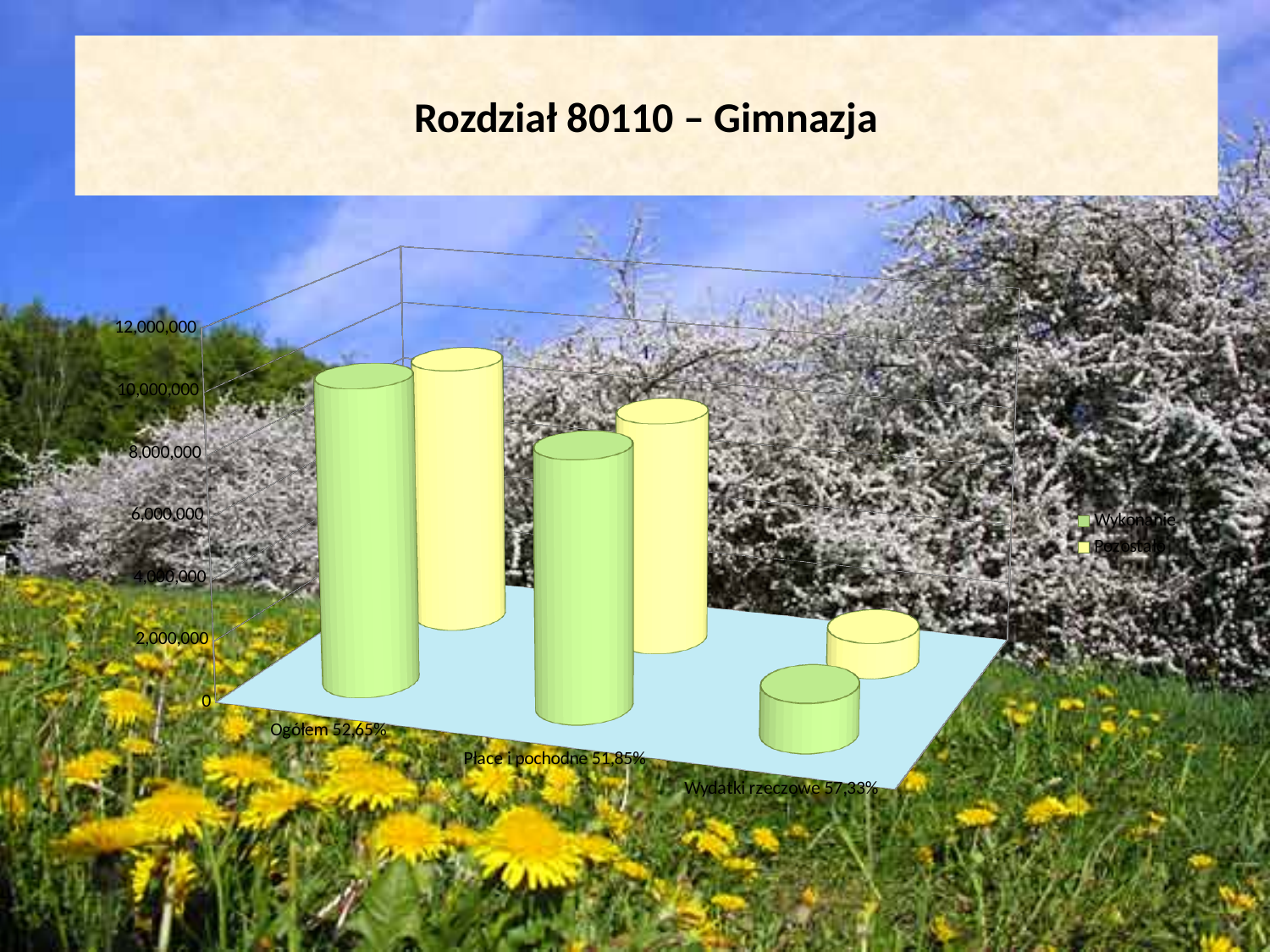
How many series does the chart's legend list? 2 What are the two series named in the chart's legend? Wykonanie and Pozostało Is the Wykonanie value for Wydatki rzeczowe greater or less than 2,000,000? less What is the title of the slide containing the chart? Rozdział 80110 – Gimnazja Which is larger: the Pozostało value for Ogółem or the Pozostało value for Wydatki rzeczowe? Ogółem Which category has the lowest Wykonanie value? Wydatki rzeczowe 57,33% Which category has the highest Wykonanie value? Ogółem 52,65% Is the Wykonanie value for Płace i pochodne greater or less than 4,000,000? greater Is the Wykonanie value for Ogółem greater or less than 6,000,000? greater What kind of chart is shown on the slide? bar chart Which category has the lowest Pozostało value? Wydatki rzeczowe 57,33% How many categories are shown on the x axis of the chart? 3